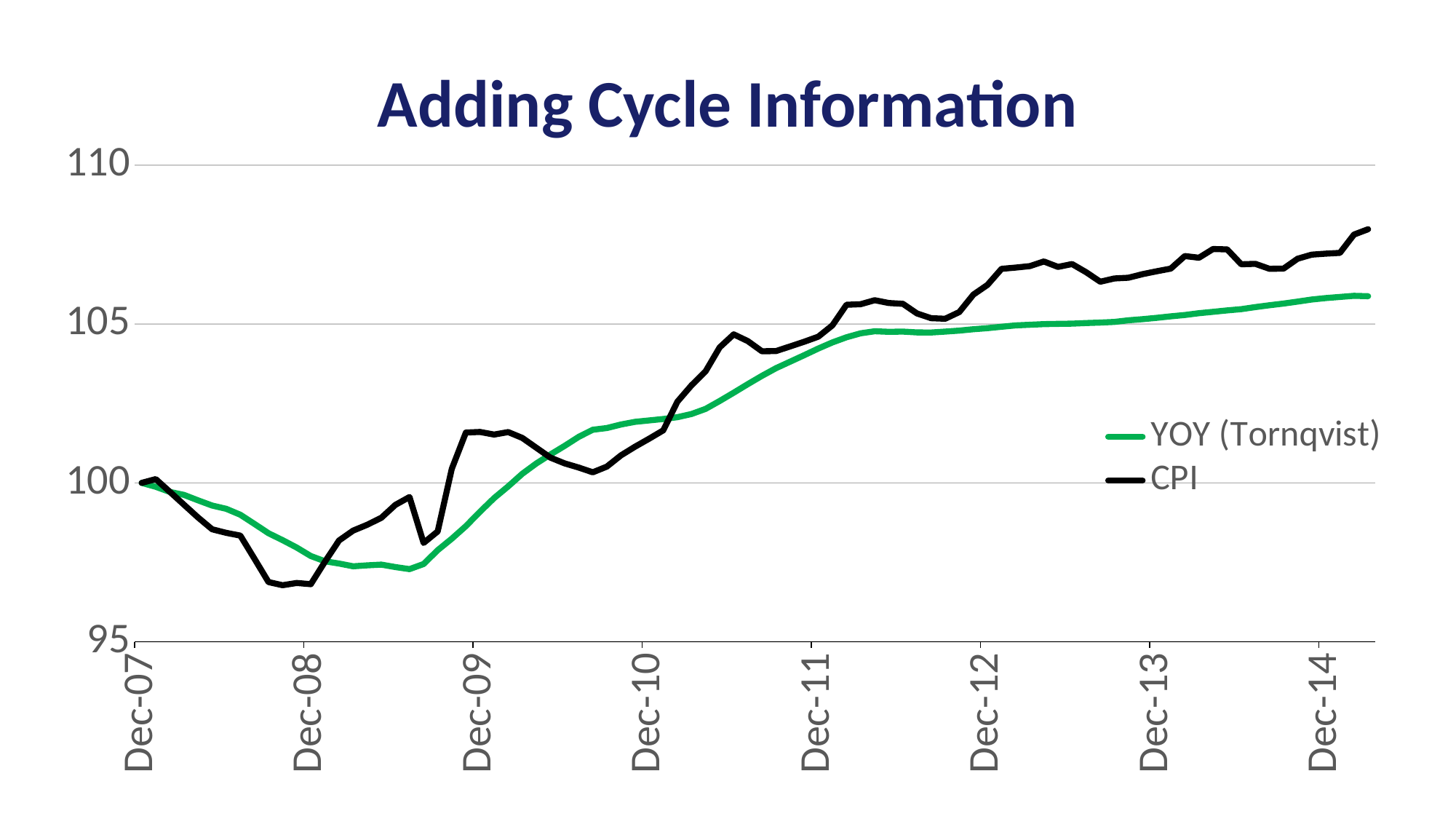
What colour is the CPI line? black Is the CPI value at Dec-14 greater or less than 105? greater What is the title of the chart? Adding Cycle Information Is the YOY (Tornqvist) value at Dec-11 greater or less than 105? less Overall, do the values of the YOY (Tornqvist) series rise or fall from Dec-09 to Dec-14? rise How many series does the legend list? 2 What is the value of the CPI series at Dec-07? 100 Is the CPI value at Dec-10 greater or less than 105? less What kind of chart is shown on the slide? line chart At Dec-14, which series has the higher value, CPI or YOY (Tornqvist)? CPI Which series reaches the lowest value anywhere on the chart? CPI